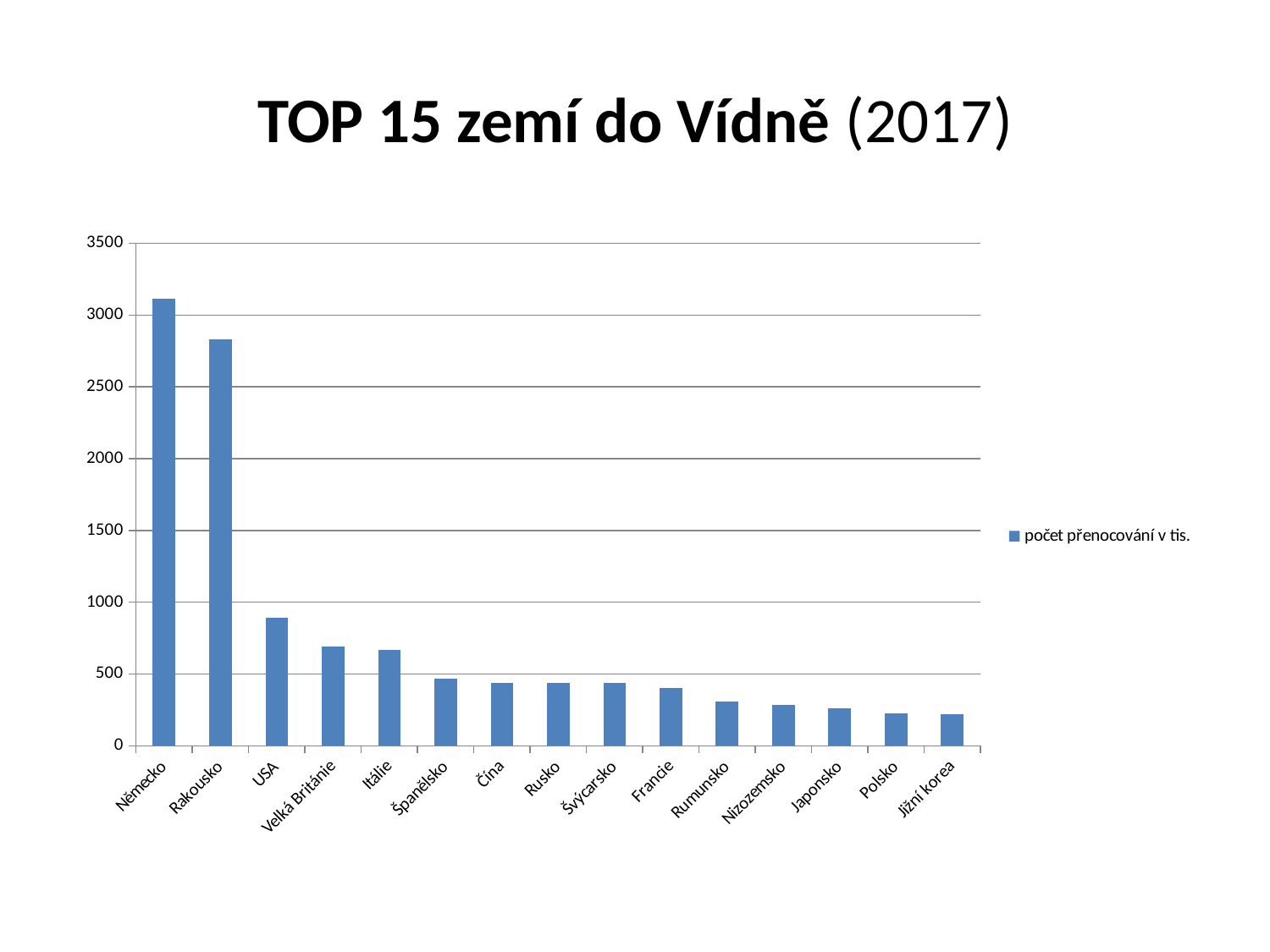
Which has a larger value, USA or Velká Británie? USA Do the values rise or fall from left to right along the x axis? fall Is the value for Německo greater or less than 3000? greater What kind of chart is shown on the slide? bar chart Is the value for Rumunsko greater or less than 500? less How many series does the legend list? 1 How many countries are shown on the x axis of the chart? 15 Is the value for Rakousko greater or less than 3000? less Which country has the highest value in the chart? Německo What is the legend entry for the series in the chart? počet přenocování v tis.